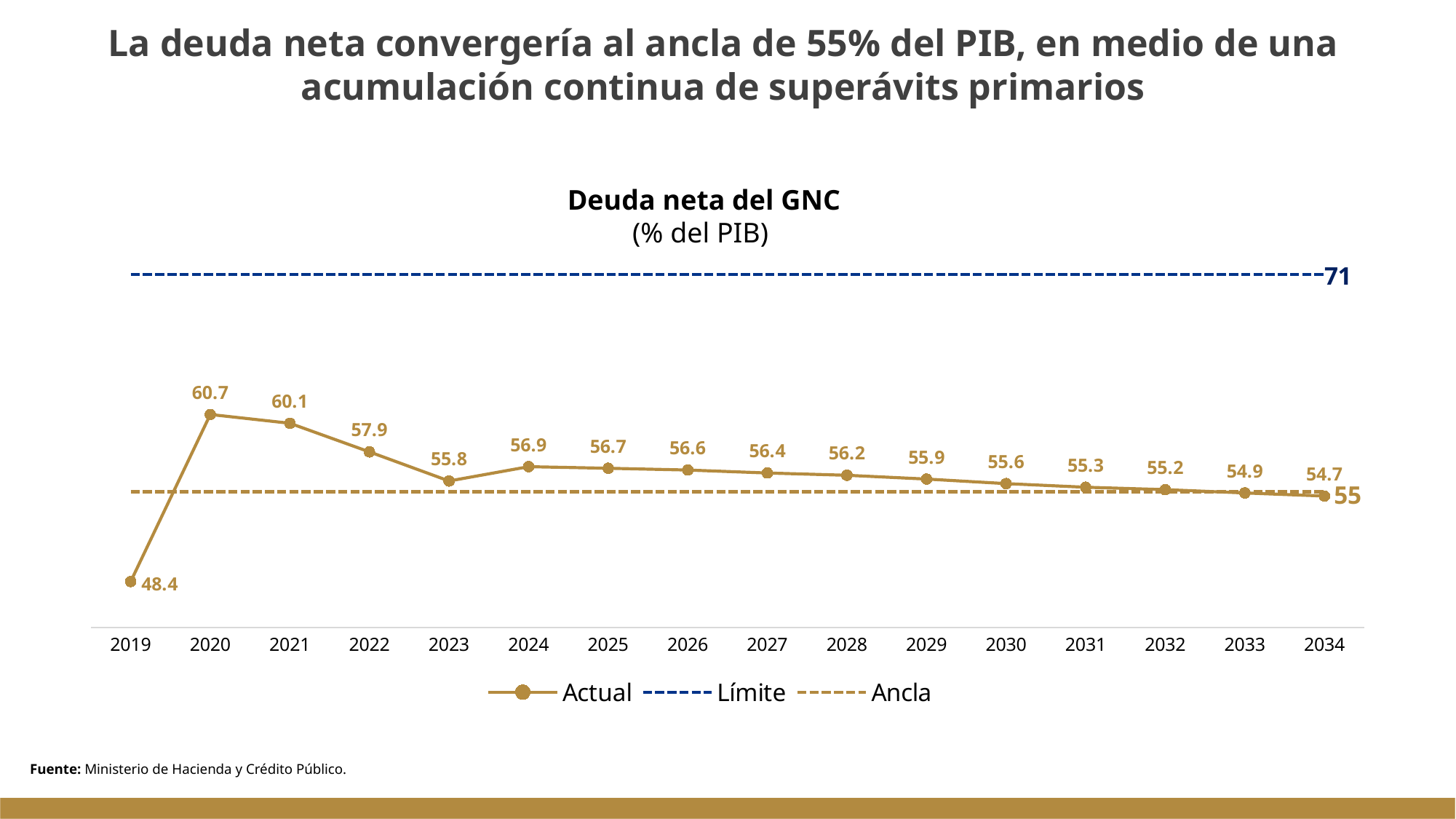
Do the Actual values rise or fall from 2024 to 2034? fall How many series does the legend list? 3 Which year has the highest value in the Actual series? 2020 What is the value of the Actual series for 2034? 54.7 How many years are shown on the x axis? 16 What is the difference between the Actual values for 2020 and 2019? 12.3 Which year has the lowest value in the Actual series? 2019 What is the value of the Actual series for 2020? 60.7 Which is larger, the Actual value for 2021 or for 2022? 2021 What kind of chart is shown? line chart What value is labelled on the Límite dashed line? 71 What is the value of the Actual series for 2023? 55.8